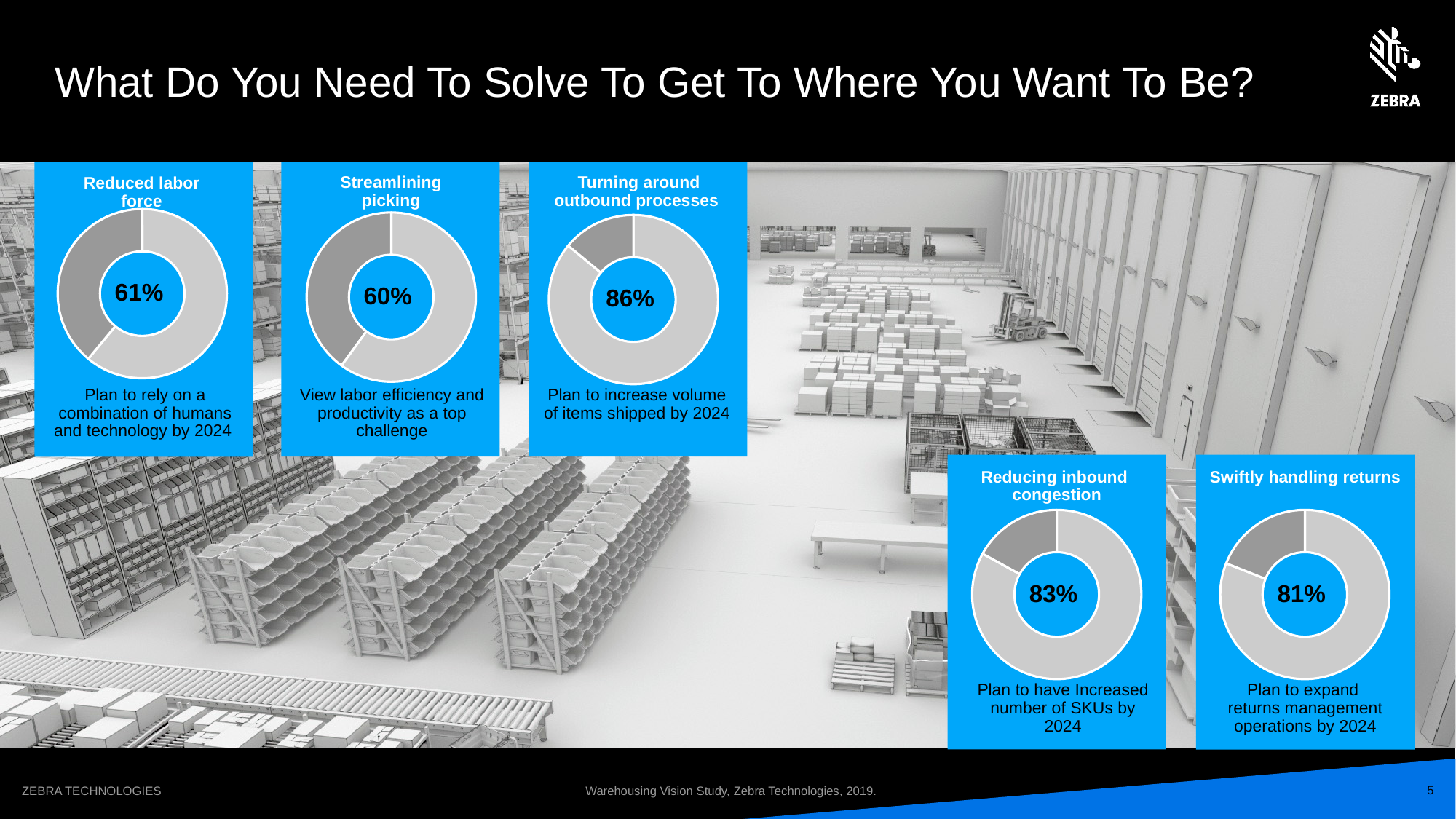
Across the five donut charts on the slide, which chart shows the highest percentage? Turning around outbound processes On the 'Swiftly handling returns' chart, what percentage plan to expand returns management operations by 2024? 81% What is the difference between the percentage on the 'Turning around outbound processes' chart and the percentage on the 'Swiftly handling returns' chart? 5% On the 'Turning around outbound processes' chart, what percentage plan to increase volume of items shipped by 2024? 86% On the 'Streamlining picking' chart, what percentage is shown? 60% Across the five donut charts on the slide, which chart shows the lowest percentage? Streamlining picking What kind of chart is used for the 'Reduced labor force' figure? Donut chart On the 'Reduced labor force' chart, what percentage is shown? 61% On the 'Reducing inbound congestion' chart, what percentage plan to have increased number of SKUs by 2024? 83% How many donut charts are shown on the slide? 5 What is the title of the slide containing these charts? What Do You Need To Solve To Get To Where You Want To Be? Which shows a larger percentage: the 'Reducing inbound congestion' chart or the 'Reduced labor force' chart? Reducing inbound congestion